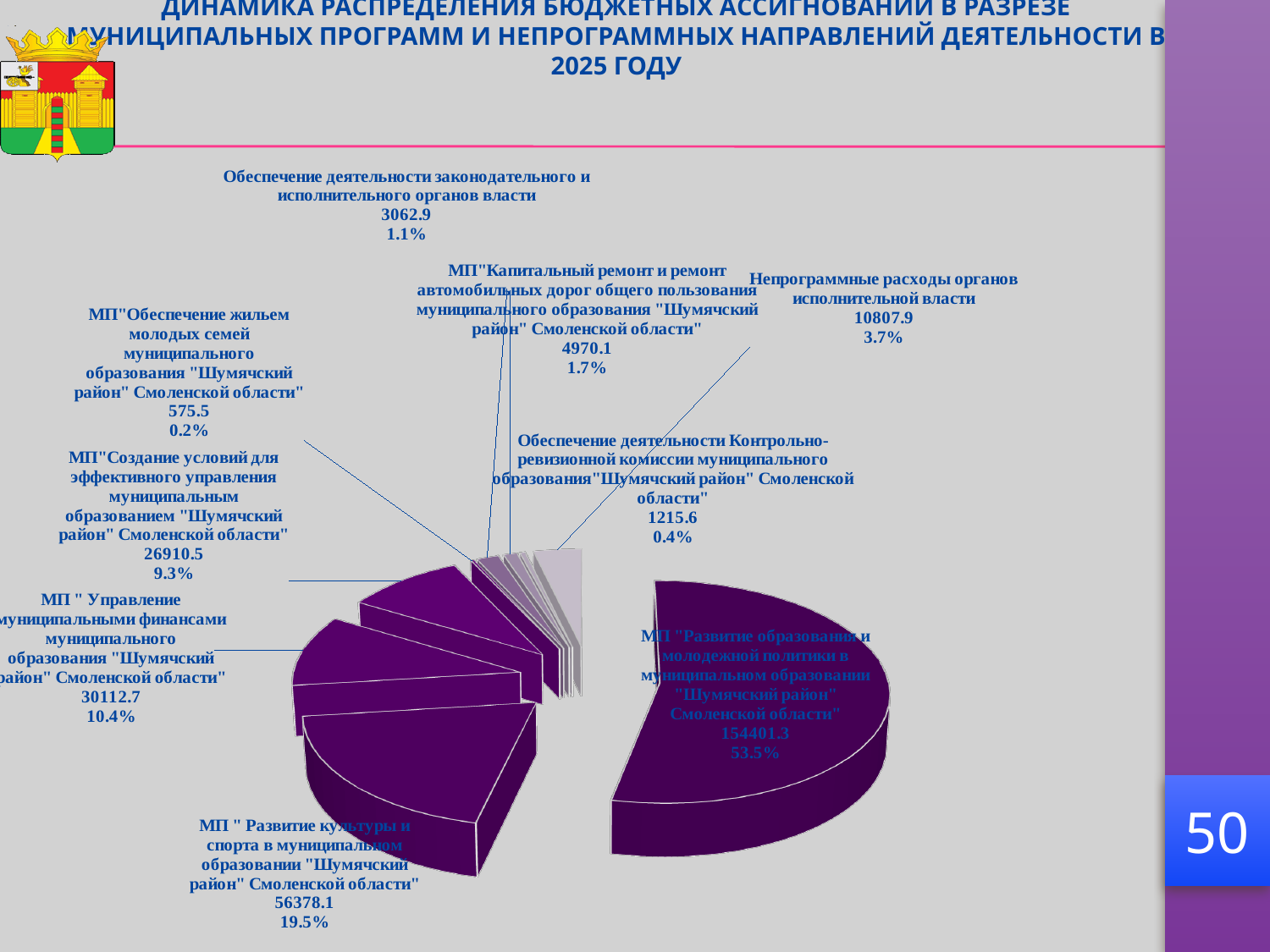
What value is shown for МП "Капитальный ремонт и ремонт автомобильных дорог общего пользования..."? 4970.1 What value is shown for МП "Развитие образования и молодежной политики в муниципальном образовании "Шумячский район" Смоленской области"? 154401.3 What percentage is shown for Обеспечение деятельности Контрольно-ревизионной комиссии муниципального образования "Шумячский район" Смоленской области? 0.4% What is the difference between the values for МП "Управление муниципальными финансами..." (30112.7) and МП "Создание условий для эффективного управления..." (26910.5)? 3202.2 Which year does the chart title refer to? 2025 Which category has the largest slice of the pie? МП "Развитие образования и молодежной политики в муниципальном образовании "Шумячский район" Смоленской области" How many slices does the pie chart have? 9 What share of the pie does МП "Развитие культуры и спорта в муниципальном образовании "Шумячский район" Смоленской области" have? 19.5% Which is larger: МП "Управление муниципальными финансами..." or МП "Создание условий для эффективного управления муниципальным образованием..."? МП "Управление муниципальными финансами муниципального образования "Шумячский район" Смоленской области" What value is shown for Непрограммные расходы органов исполнительной власти? 10807.9 Which category has the smallest slice of the pie? МП "Обеспечение жильем молодых семей муниципального образования "Шумячский район" Смоленской области" What kind of chart is shown on the slide? Pie chart